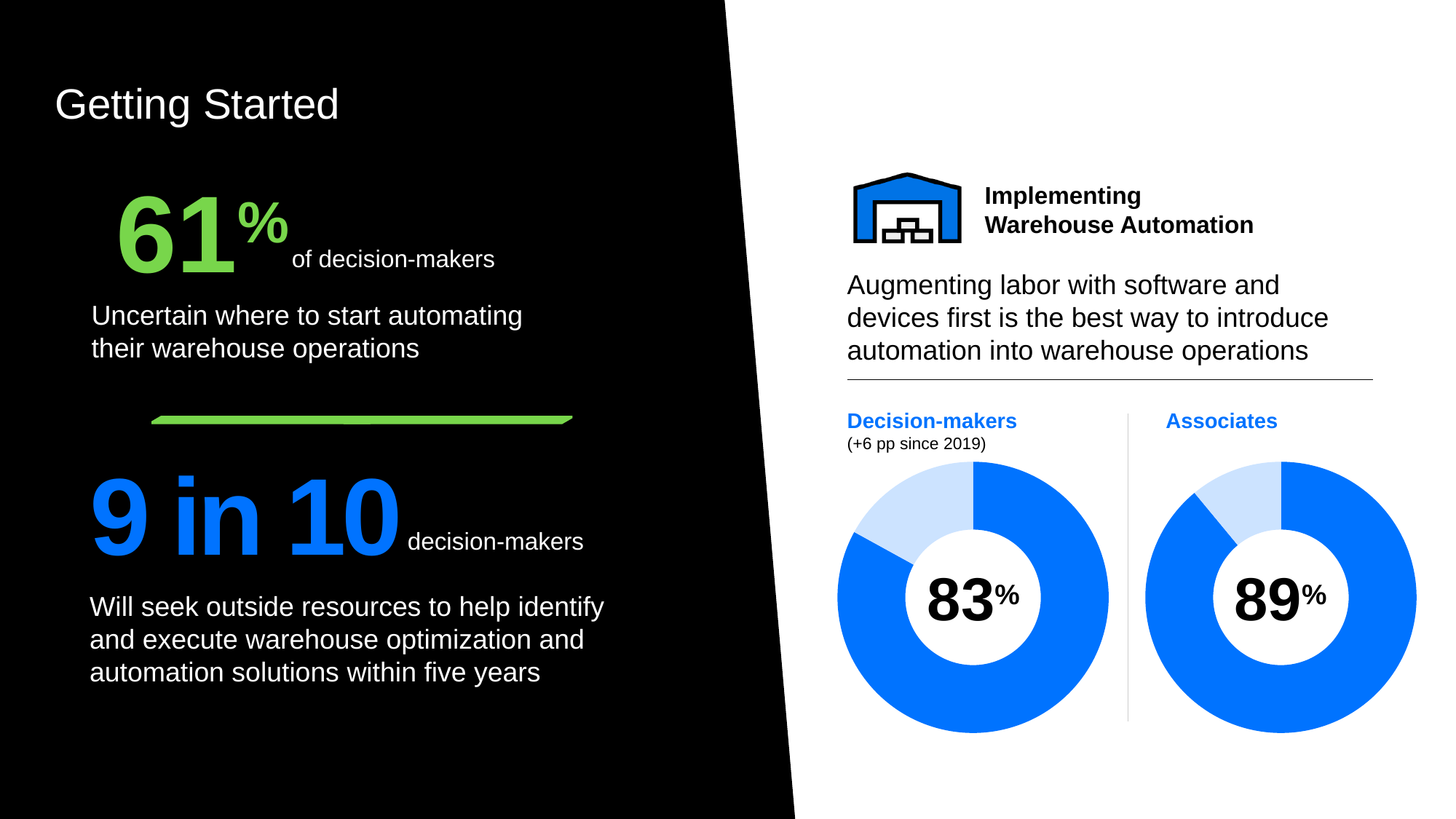
What value is shown in the centre of the Associates donut chart? 89% Which of the two donut charts, Decision-makers or Associates, shows the higher percentage? Associates In the Decision-makers donut chart, what share of the ring is the lighter, unfilled portion? 17% Which of the two donut charts, Decision-makers or Associates, shows the lower percentage? Decision-makers Is the value in the Decision-makers donut chart greater or less than 80%? greater What value is shown in the centre of the Decision-makers donut chart? 83% What is the heading above the two donut charts, next to the warehouse icon? Implementing Warehouse Automation What kind of chart is used to show the Decision-makers and Associates percentages? Donut (pie) chart How many donut charts are shown on the slide? 2 What is the difference between the Associates percentage and the Decision-makers percentage in the donut charts? 6 percentage points What change since 2019 is noted under the Decision-makers donut chart label? +6 pp since 2019 In the Associates donut chart, what share of the ring is the lighter, unfilled portion? 11%